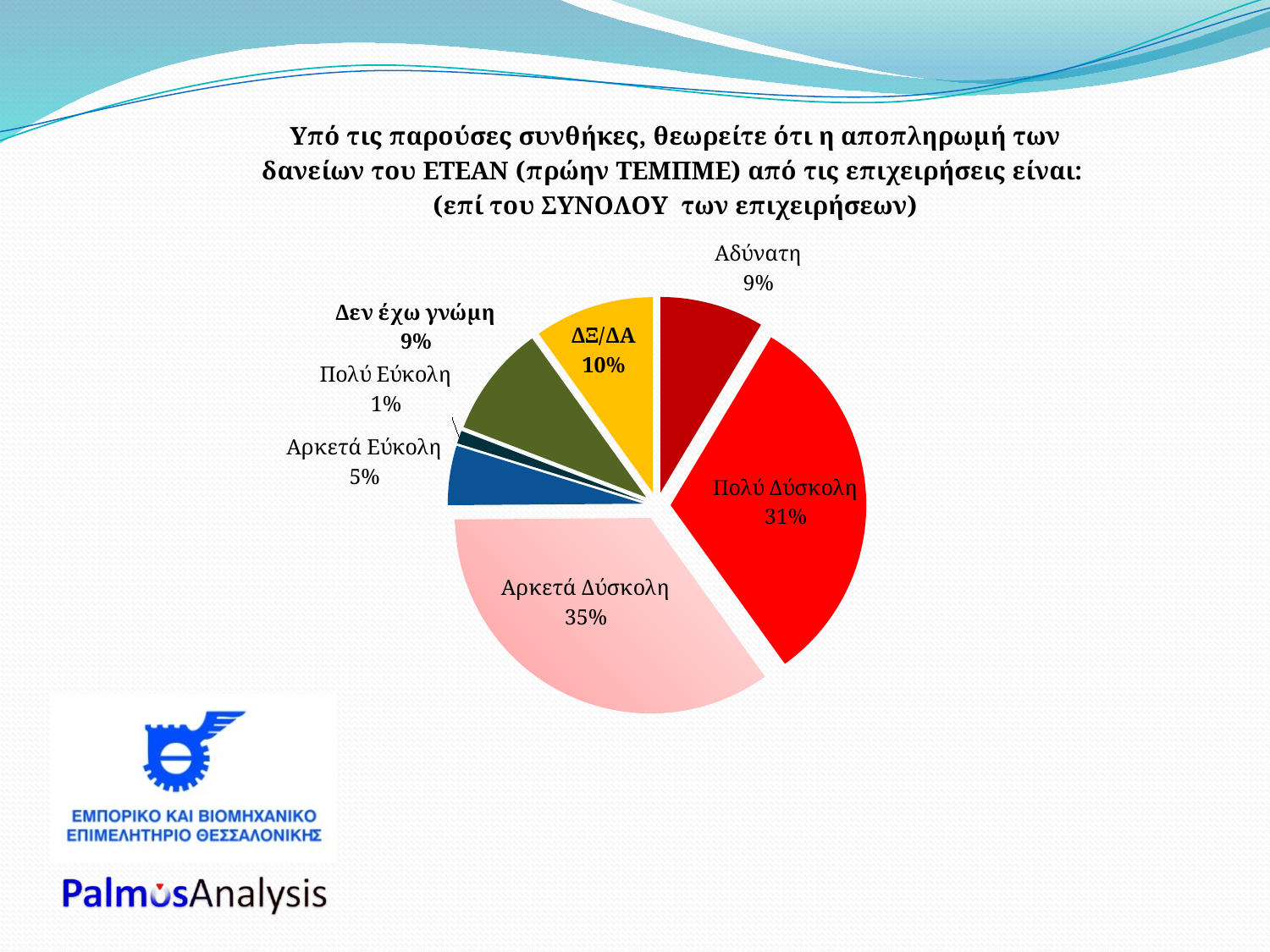
What percentage of the pie is labelled "Αρκετά Δύσκολη"? 35% What percentage of the pie is labelled "Αρκετά Εύκολη"? 5% Which slice of the pie is the smallest? Πολύ Εύκολη What percentage of the pie is labelled "Πολύ Εύκολη"? 1% What is the difference in percentage points between the "Αρκετά Δύσκολη" and "Πολύ Δύσκολη" slices? 4 What percentage of the pie is labelled "ΔΞ/ΔΑ"? 10% What percentage of the pie is labelled "Αδύνατη"? 9% What colour is the "Πολύ Δύσκολη" slice of the pie? red What percentage of the pie is labelled "Πολύ Δύσκολη"? 31% Which is larger, the "Αρκετά Εύκολη" slice or the "ΔΞ/ΔΑ" slice? ΔΞ/ΔΑ What kind of chart is shown on the slide? pie chart Which slice of the pie is the largest? Αρκετά Δύσκολη